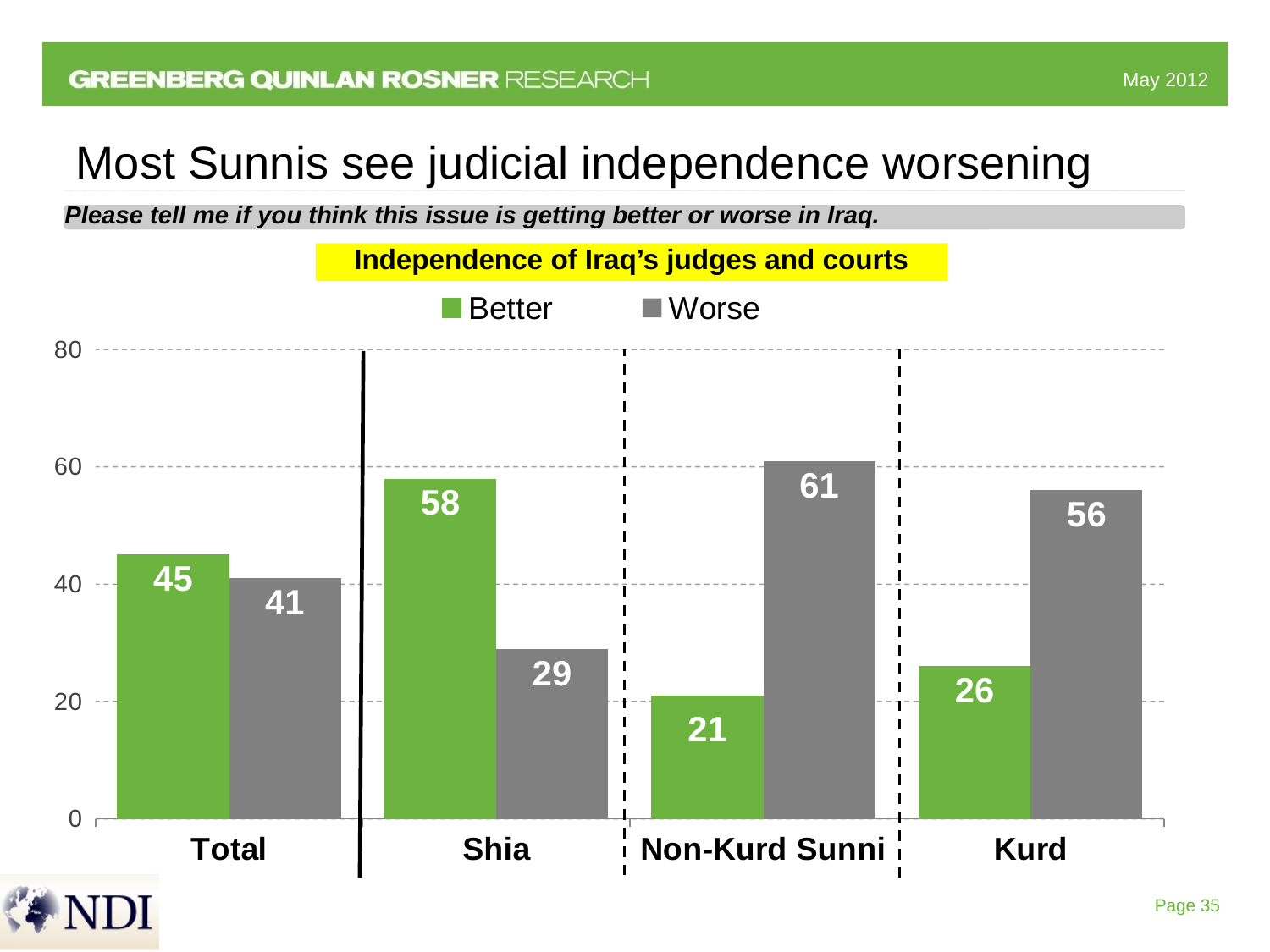
How many series does the legend list? 2 Which category has the lowest 'Better' value? Non-Kurd Sunni What is the difference between the 'Worse' and 'Better' values for Kurd? 30 What is the 'Worse' value for Non-Kurd Sunni? 61 How many categories are shown on the x axis? 4 Which category has the highest 'Worse' value? Non-Kurd Sunni Which colour represents the 'Worse' series? Grey What is the 'Better' value for Shia? 58 What kind of chart is shown on the slide? Bar chart What is the 'Better' value for Kurd? 26 Which is larger for Shia, the 'Better' value or the 'Worse' value? Better What is the 'Worse' value for Total? 41